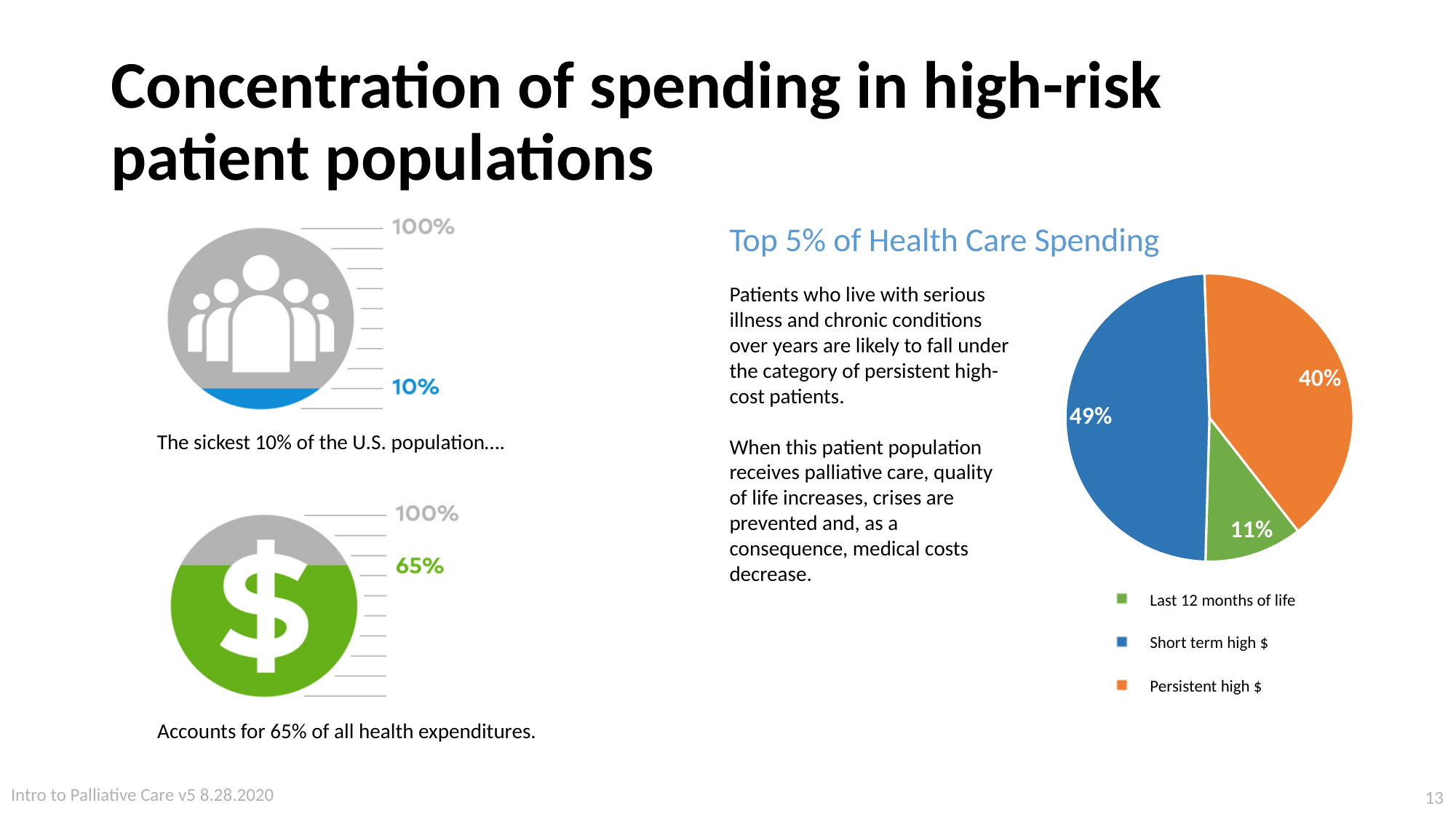
Which colour represents Persistent high $ in the pie chart? Orange What share of the pie chart does Last 12 months of life account for? 11% What is the title of the pie chart? Top 5% of Health Care Spending Which category has the smallest slice of the pie chart? Last 12 months of life What is the difference in percentage points between the Short term high $ slice and the Persistent high $ slice? 9 What kind of chart is shown on the right side of the slide? Pie chart What is the difference in percentage points between the Persistent high $ slice and the Last 12 months of life slice? 29 Which is larger in the pie chart: Persistent high $ or Last 12 months of life? Persistent high $ Which category has the largest slice of the pie chart? Short term high $ How many slices does the pie chart have? 3 What share of the pie chart does Persistent high $ account for? 40% What share of the pie chart does Short term high $ account for? 49%